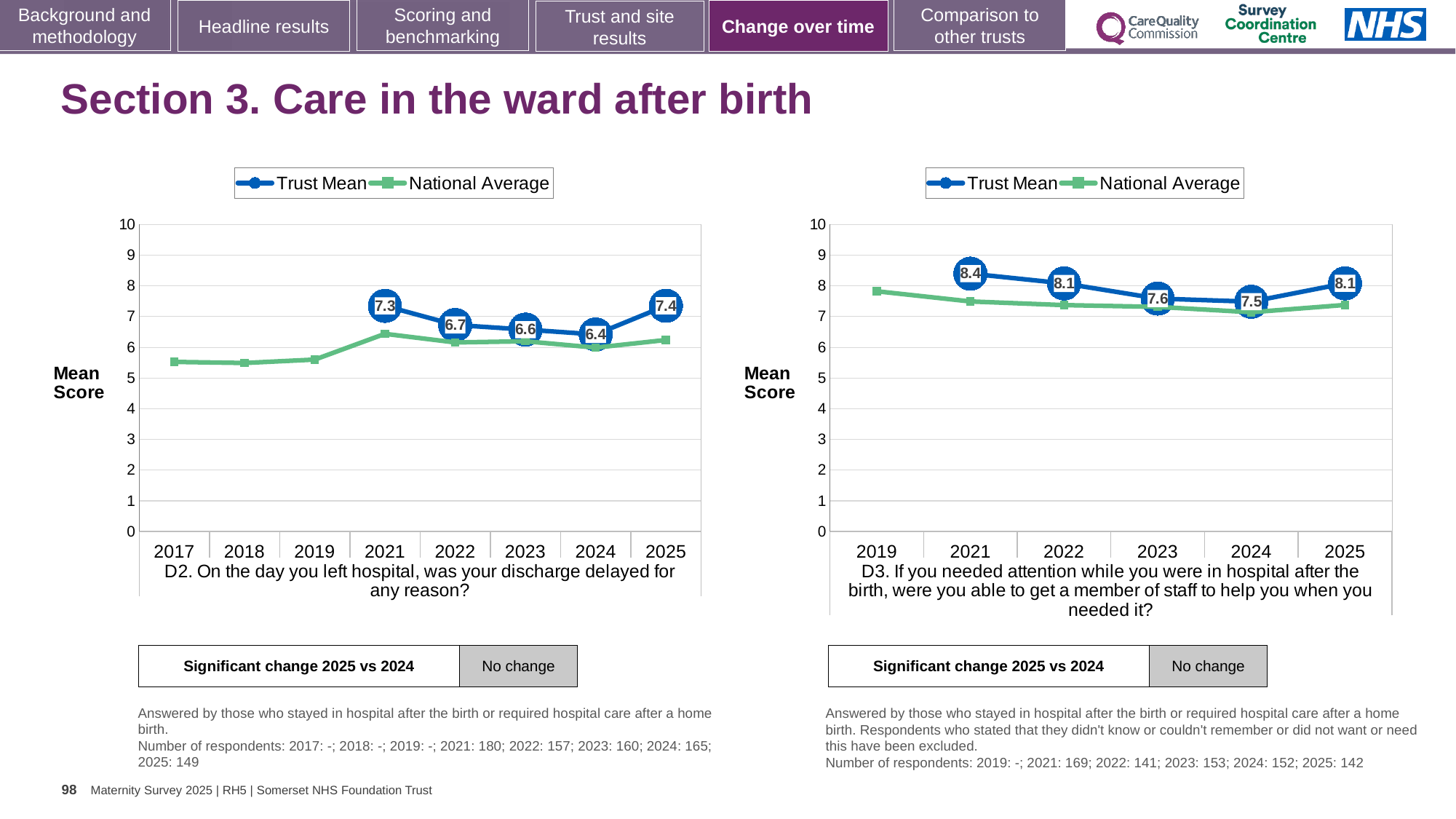
In the right chart (D3), what is the Trust Mean score for 2023? 7.6 In the left chart (D2), which year has the lowest labelled Trust Mean score? 2024 How many years are shown on the x axis of the right chart (D3)? 6 In the right chart (D3), which year has the highest Trust Mean score? 2021 In the left chart (D2), is the National Average value for 2017 greater or less than 6? less What type of chart is the left chart (D2)? line chart In the right chart (D3), what is the difference between the Trust Mean scores for 2021 and 2024? 0.9 In the left chart (D2), what is the difference between the Trust Mean scores for 2025 and 2024? 1.0 How many series does the legend of the left chart (D2) list? 2 In the left chart (D2), what is the Trust Mean score for 2025? 7.4 In the left chart (D2), what is the Trust Mean score for 2021? 7.3 In the right chart (D3), is the Trust Mean score for 2022 higher or lower than for 2023? higher